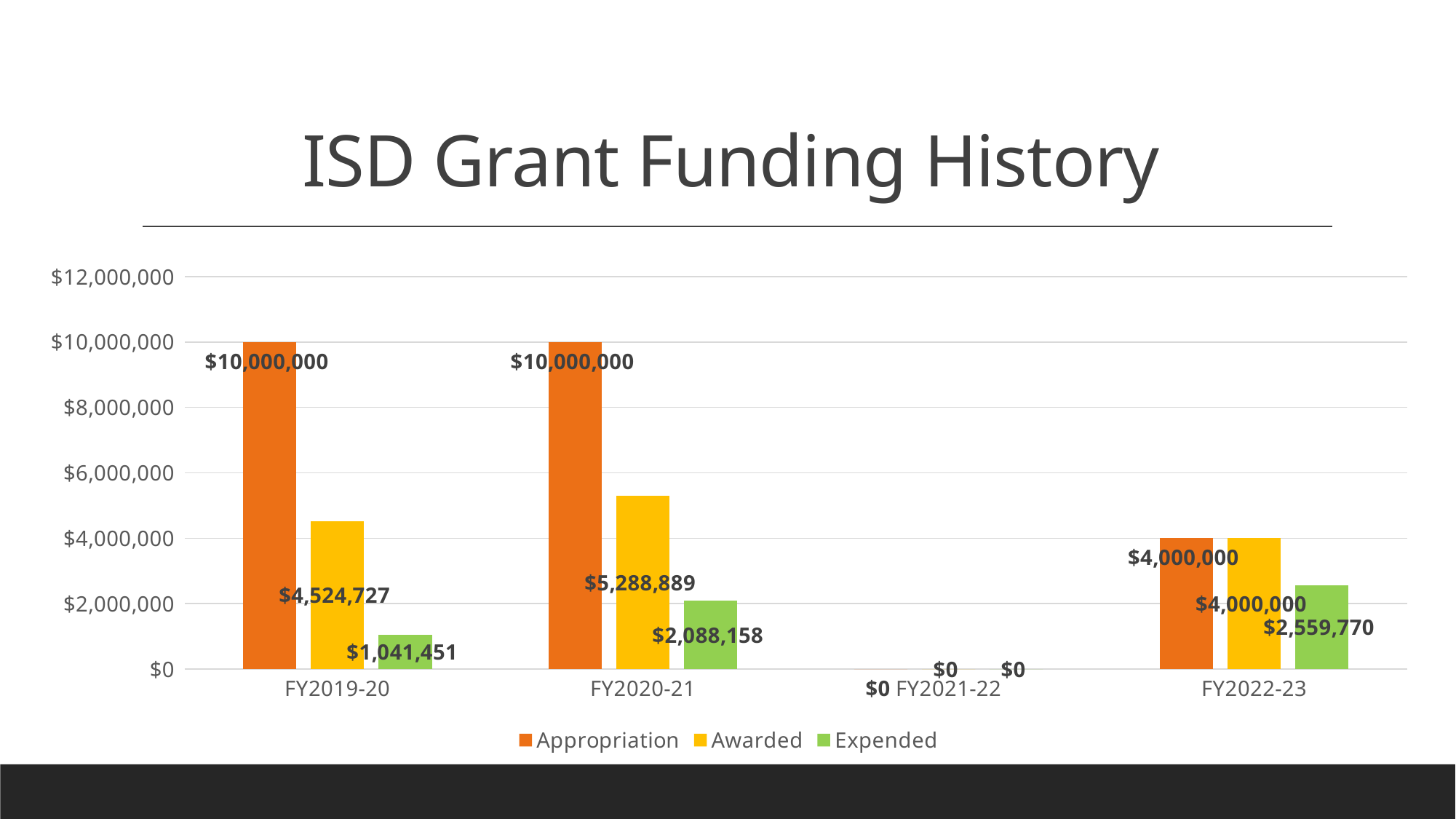
What is the difference between the Appropriation and Awarded values for FY2019-20? $5,475,273 Which is larger, the Expended value for FY2020-21 or for FY2019-20? FY2020-21 How many series does the legend list? 3 Which fiscal year has the highest Expended value? FY2022-23 How many fiscal years are shown on the x axis? 4 Which fiscal year has the lowest Awarded value? FY2021-22 What is the Expended value for FY2019-20? $1,041,451 What is the Expended value for FY2022-23? $2,559,770 What is the Appropriation value for FY2019-20? $10,000,000 What kind of chart is shown on the slide? Bar chart What is the Awarded value for FY2020-21? $5,288,889 What is the difference between the Awarded values for FY2020-21 and FY2019-20? $764,162